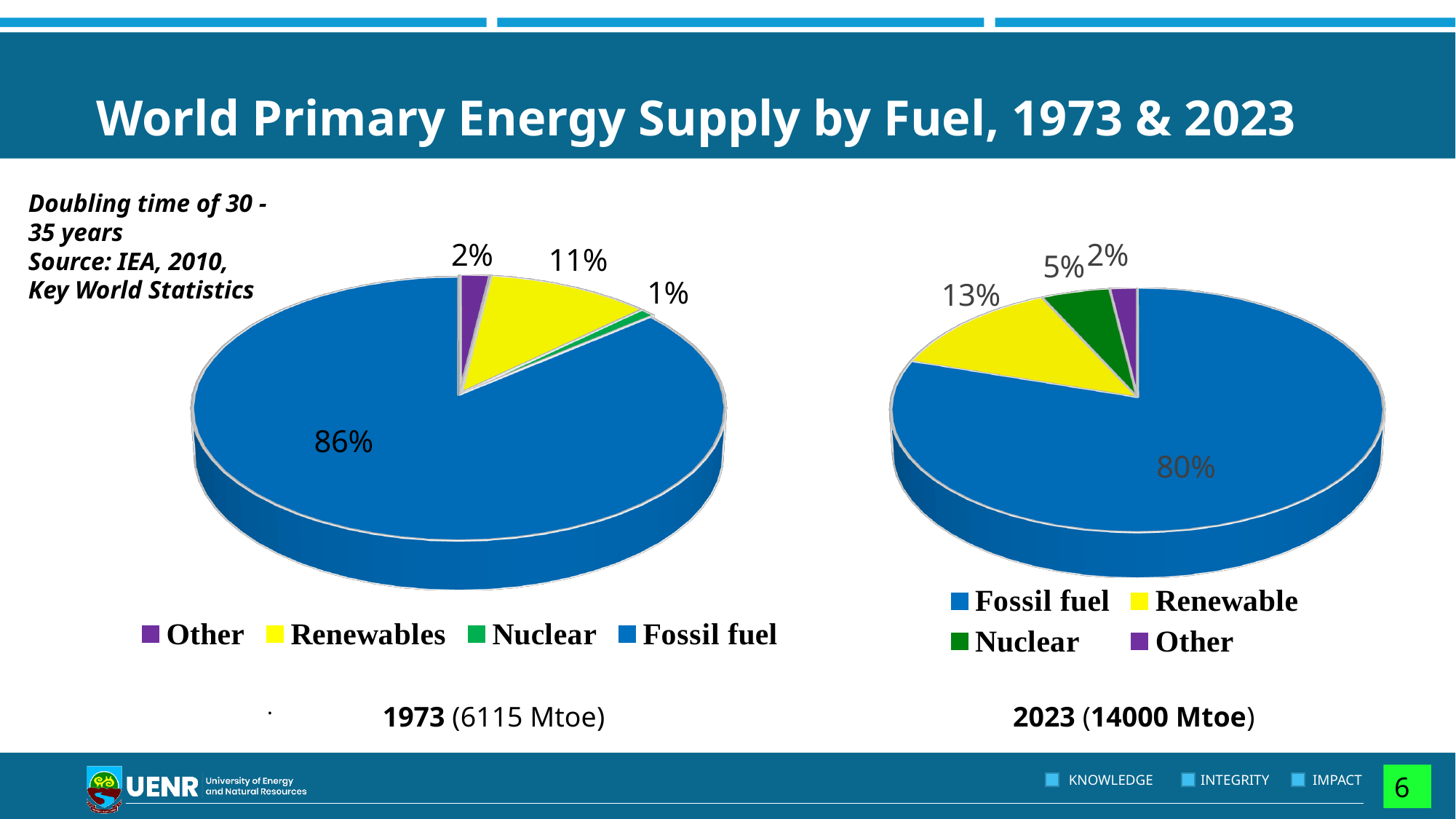
In the 2023 pie chart, which category has the smallest slice? Other In the 1973 pie chart, which category has the largest slice? Fossil fuel What type of chart is used for the 1973 data? Pie chart In the 2023 pie chart, what share does Renewable have? 13% In the 1973 pie chart, what share does Fossil fuel have? 86% How many slices does the 2023 pie chart have? 4 In the 2023 pie chart, what share does Nuclear have? 5% Is the Renewables share larger in the 1973 pie chart or the Renewable share in the 2023 pie chart? 2023 In the 1973 pie chart, which category has the smallest slice? Nuclear What is the difference between the Fossil fuel share in the 1973 pie chart and the Fossil fuel share in the 2023 pie chart? 6% In the 1973 pie chart, what colour represents Renewables? Yellow In the 1973 pie chart, what share does Nuclear have? 1%